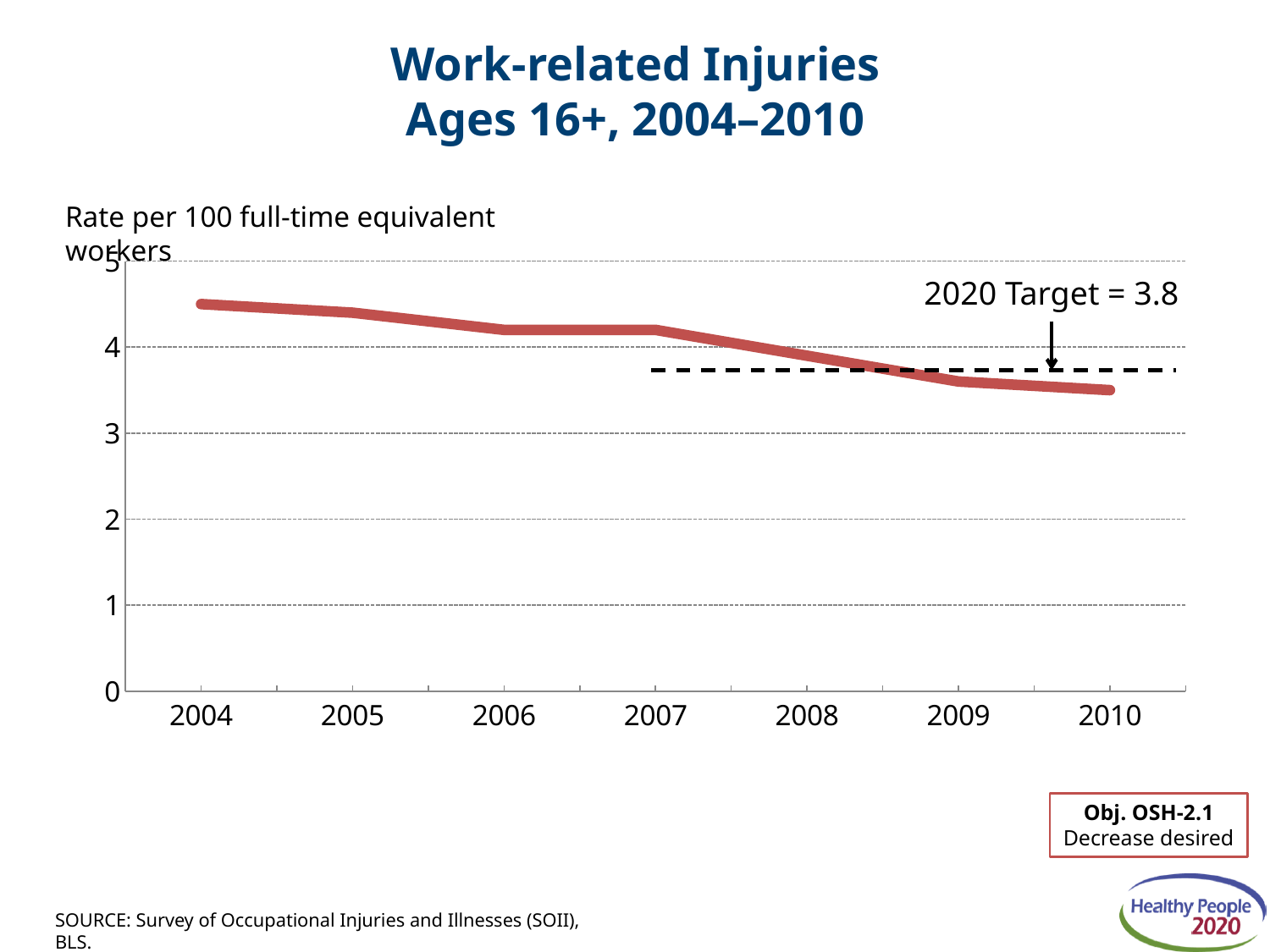
Which is larger, the value for 2004 or the value for 2010? 2004 What kind of chart is shown on the slide? line chart Is the value for 2006 greater or less than 4? greater What is the 2020 target shown on the chart? 3.8 Does the work-related injury rate rise or fall from 2004 to 2010? fall Which year has the highest work-related injury rate? 2004 Is the value for 2010 greater or less than 4? less Is the value for 2010 greater or less than 3? greater How many years are plotted on the x axis? 7 What is the y-axis label of the chart? Rate per 100 full-time equivalent workers